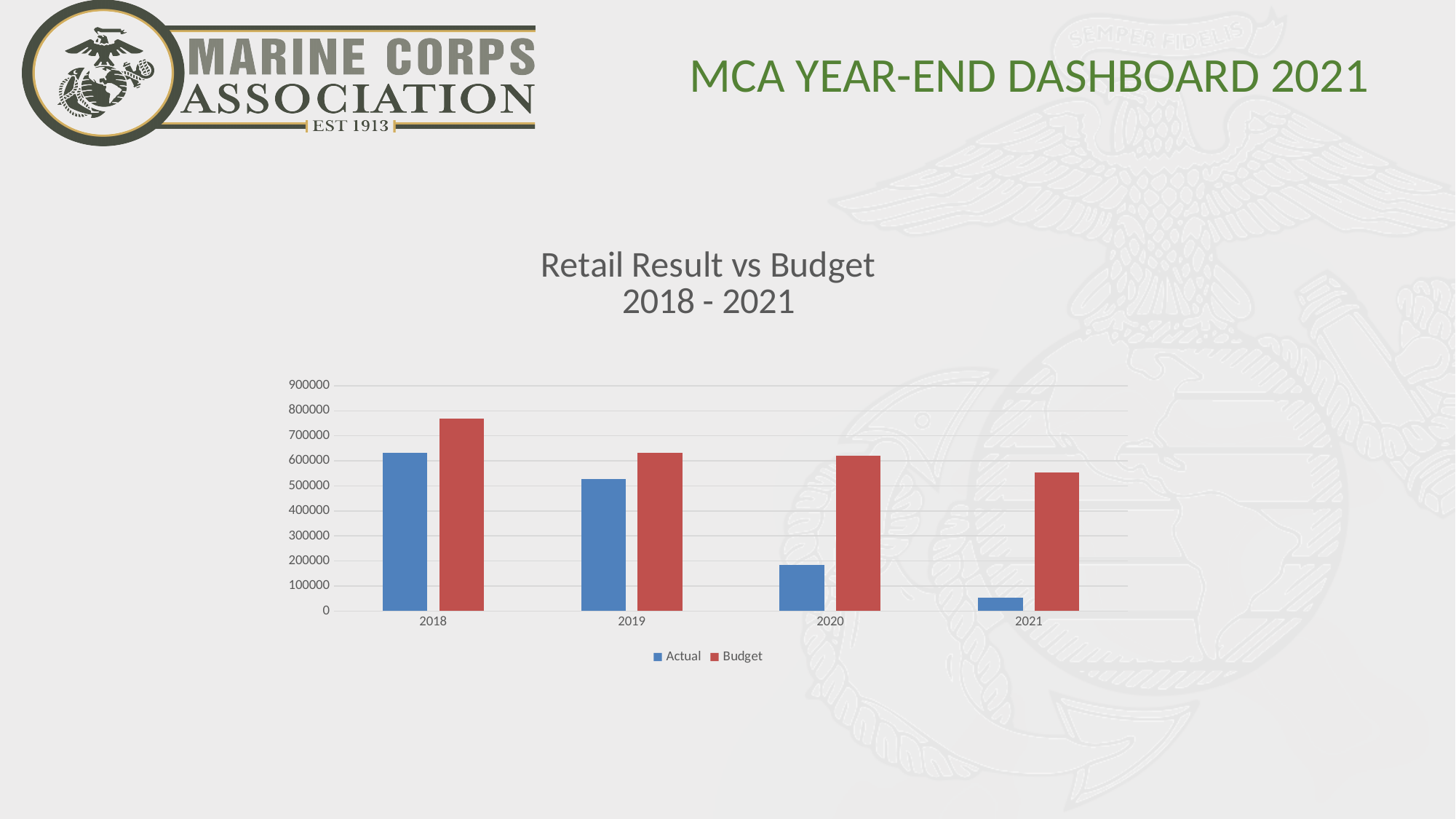
In which year is the Budget value highest? 2018 In which year is the Actual value highest? 2018 Do the Actual values rise or fall from 2018 to 2021? fall Is the Actual value for 2020 greater or less than 300000? less What kind of chart is shown on the slide? bar chart How many series does the legend list? 2 In which year is the Actual value lowest? 2021 Which series is shown in blue? Actual In 2020, which is larger, Actual or Budget? Budget How many years are shown on the x axis? 4 What is the title of the chart? Retail Result vs Budget 2018 - 2021 Is the Budget value for 2018 greater or less than 700000? greater